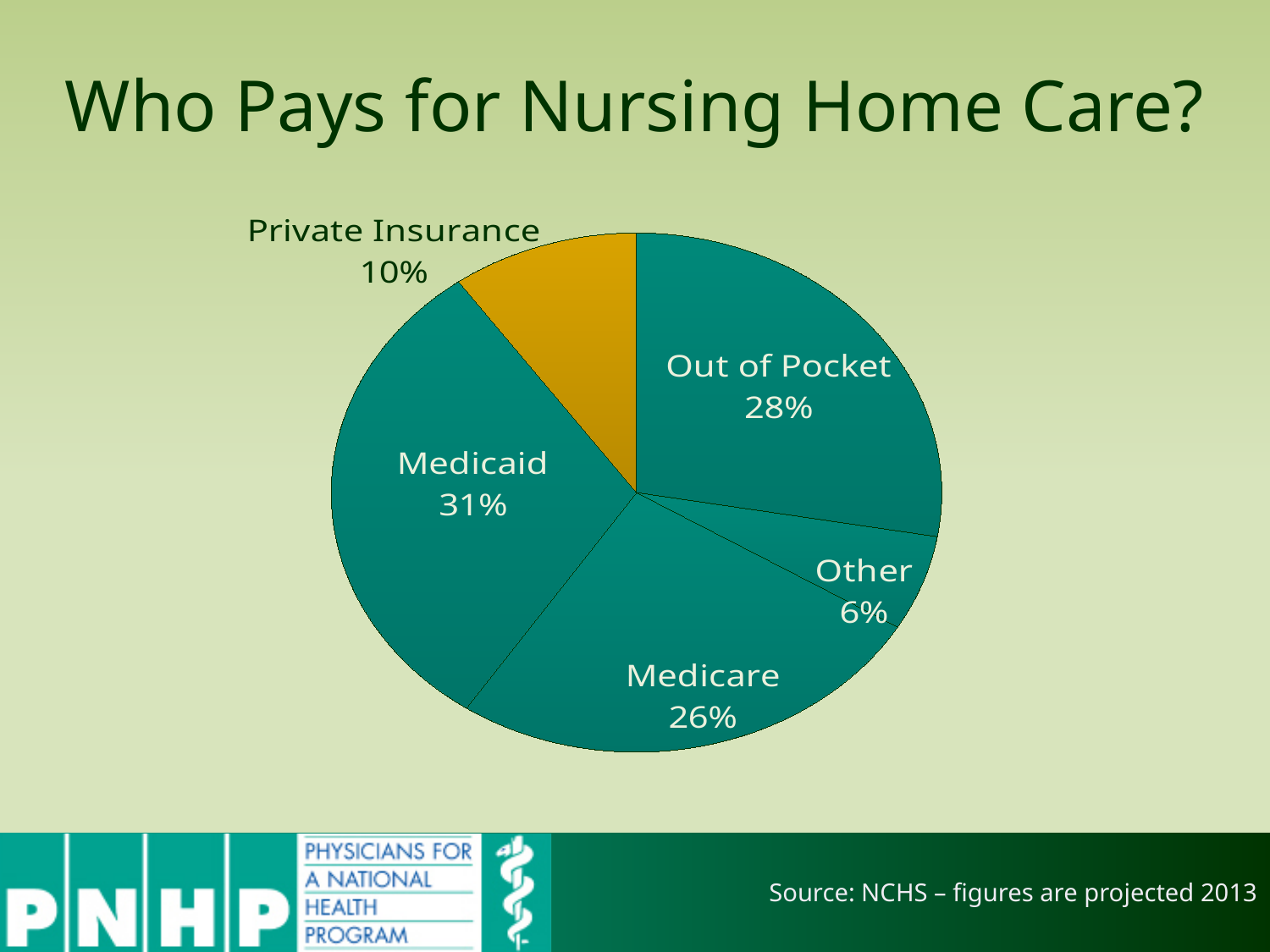
How many slices does the pie chart have? 5 What type of chart is shown on the slide? Pie chart What share of nursing home care is paid by Medicaid? 31% How many percentage points larger is the Medicaid share than the Medicare share? 5 Which payer has the smallest share of nursing home care? Other Which payer has the largest share of nursing home care? Medicaid What share of nursing home care is paid by 'Other' sources? 6% What share of nursing home care is paid out of pocket? 28% Which is larger, the Out of Pocket share or the Medicare share? Out of Pocket What is the difference in percentage points between the Out of Pocket share and the Private Insurance share? 18 What share of nursing home care is paid by private insurance? 10% What share of nursing home care is paid by Medicare? 26%